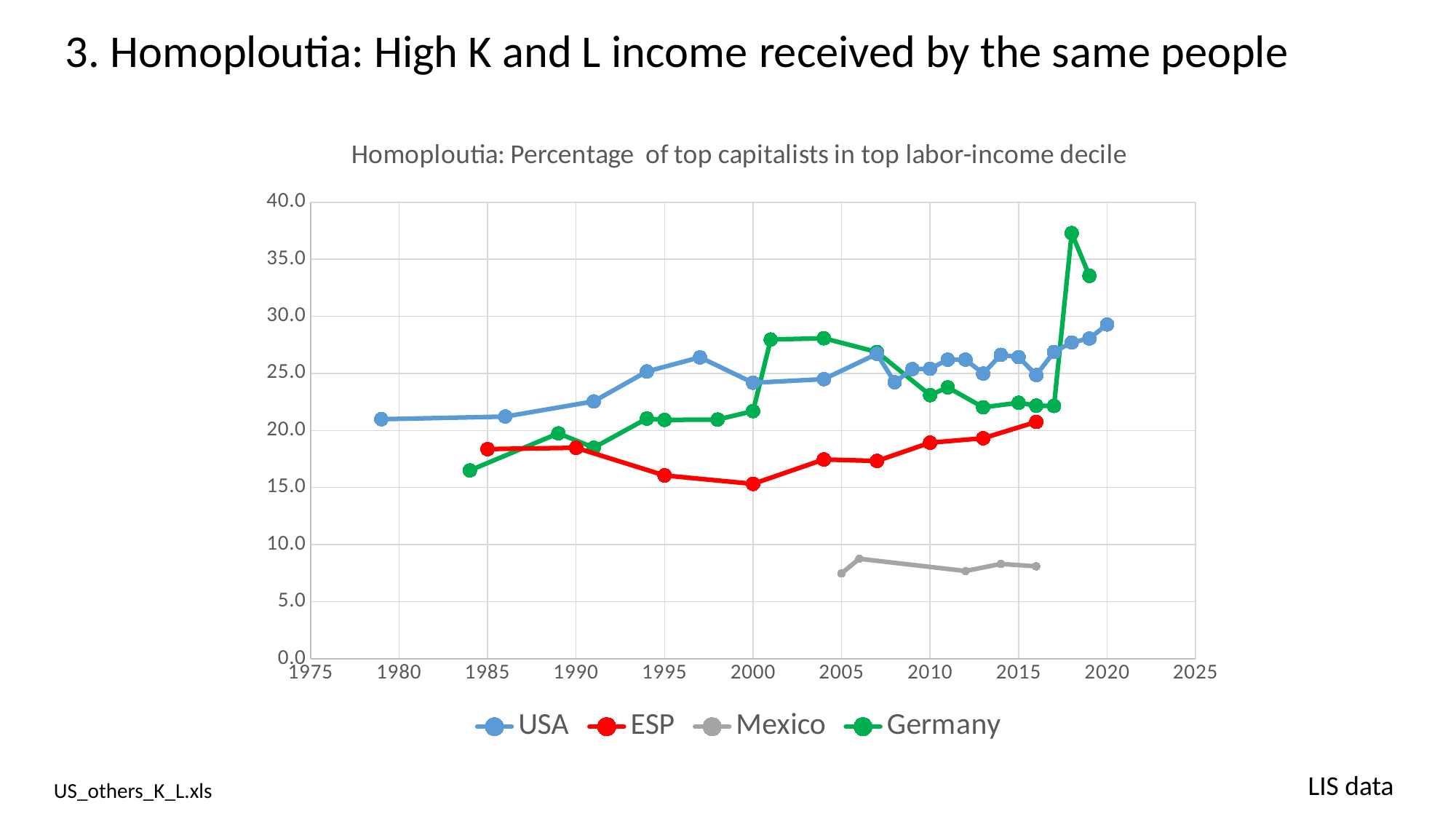
Which series has the lowest values throughout the chart? Mexico Is the value for USA in 2020 greater or less than 25.0? greater What kind of chart is shown on the slide? line chart How many series does the legend list? 4 In 2010, which series has the higher value, USA or ESP? USA What is the title of the chart? Homoploutia: Percentage of top capitalists in top labor-income decile Which series are listed in the legend? USA, ESP, Mexico, Germany Which series reaches the highest value on the chart? Germany Is the value for Germany in 2018 greater or less than 35.0? greater Does the ESP series rise or fall between 2000 and 2016? rise Is the value for Mexico in 2005 greater or less than 10.0? less